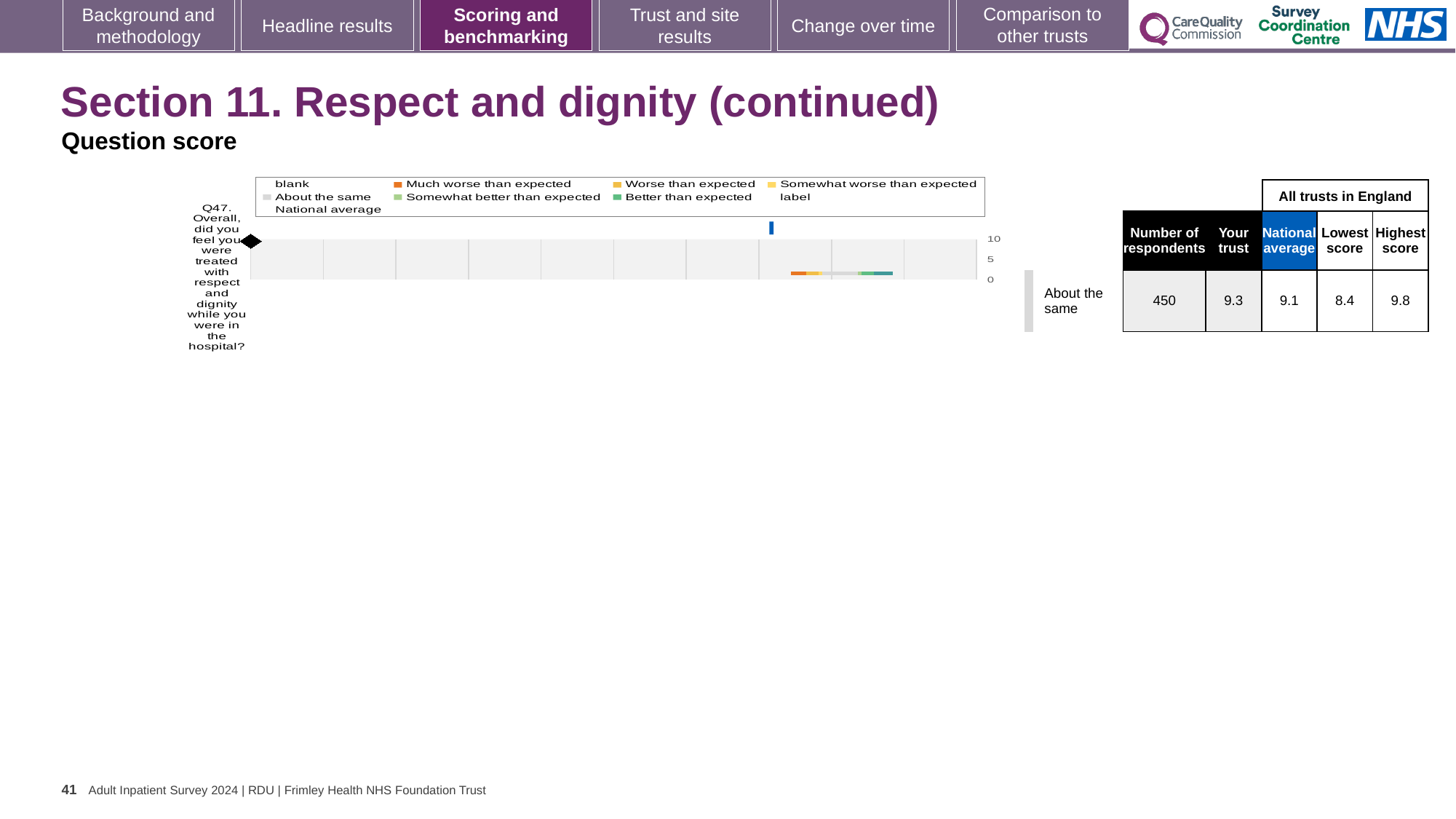
What is the highest score among all trusts in England for Q47? 9.8 Which benchmarking category is the trust's Q47 result placed in? About the same What is the maximum value shown on the chart's score axis? 10 What is the lowest score among all trusts in England for Q47? 8.4 What is the national average score for Q47? 9.1 What is the 'Your trust' score for Q47 (treated with respect and dignity)? 9.3 Which is higher for Q47: the trust's score or the national average? Your trust (9.3) What type of chart is used to show the Q47 question score? bar chart How many entries does the chart legend list? 9 How many respondents answered Q47? 450 What is the difference between the highest and lowest scores for Q47 across all trusts in England? 1.4 How many survey questions are plotted on the chart? 1